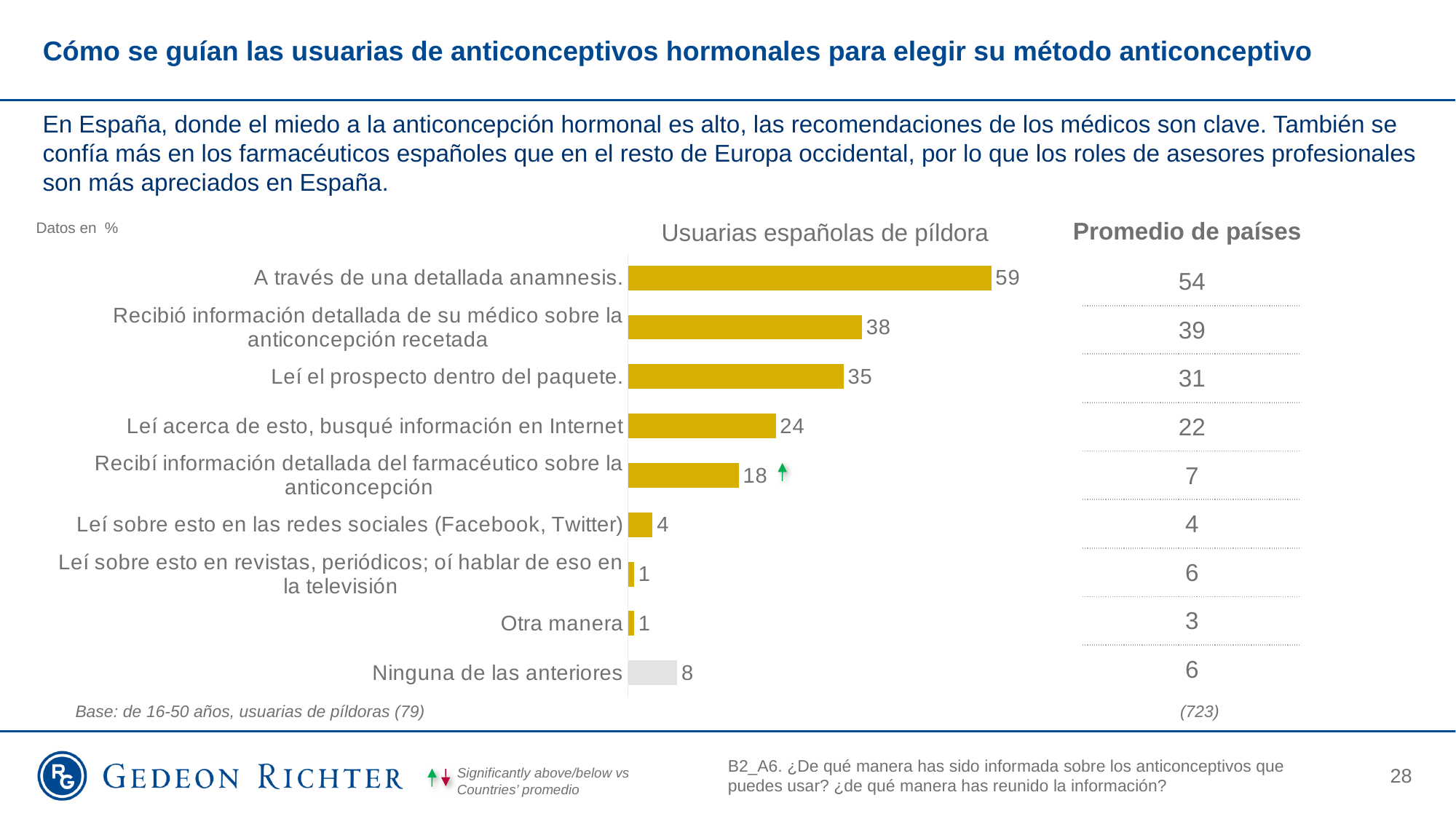
Which is larger among Usuarias españolas de píldora: "Leí acerca de esto, busqué información en Internet" or "Leí sobre esto en las redes sociales (Facebook, Twitter)"? Leí acerca de esto, busqué información en Internet What is the value for "Ninguna de las anteriores" among Usuarias españolas de píldora? 8 What is the value for "A través de una detallada anamnesis." among Usuarias españolas de píldora? 59 What is the difference between the values for "Recibió información detallada de su médico sobre la anticoncepción recetada" and "Leí el prospecto dentro del paquete." among Usuarias españolas de píldora? 3 Is the Usuarias españolas de píldora value for "A través de una detallada anamnesis." higher or lower than its Promedio de países value? higher Which category has the highest value among Usuarias españolas de píldora? A través de una detallada anamnesis. What is the title of the bar chart column? Usuarias españolas de píldora What is the Promedio de países value for "Recibí información detallada del farmacéutico sobre la anticoncepción"? 7 What is the value for "Leí el prospecto dentro del paquete." among Usuarias españolas de píldora? 35 What is the difference between the Usuarias españolas de píldora value and the Promedio de países value for "Recibí información detallada del farmacéutico sobre la anticoncepción"? 11 What kind of chart is shown on the slide? bar chart How many categories are shown in the bar chart? 9